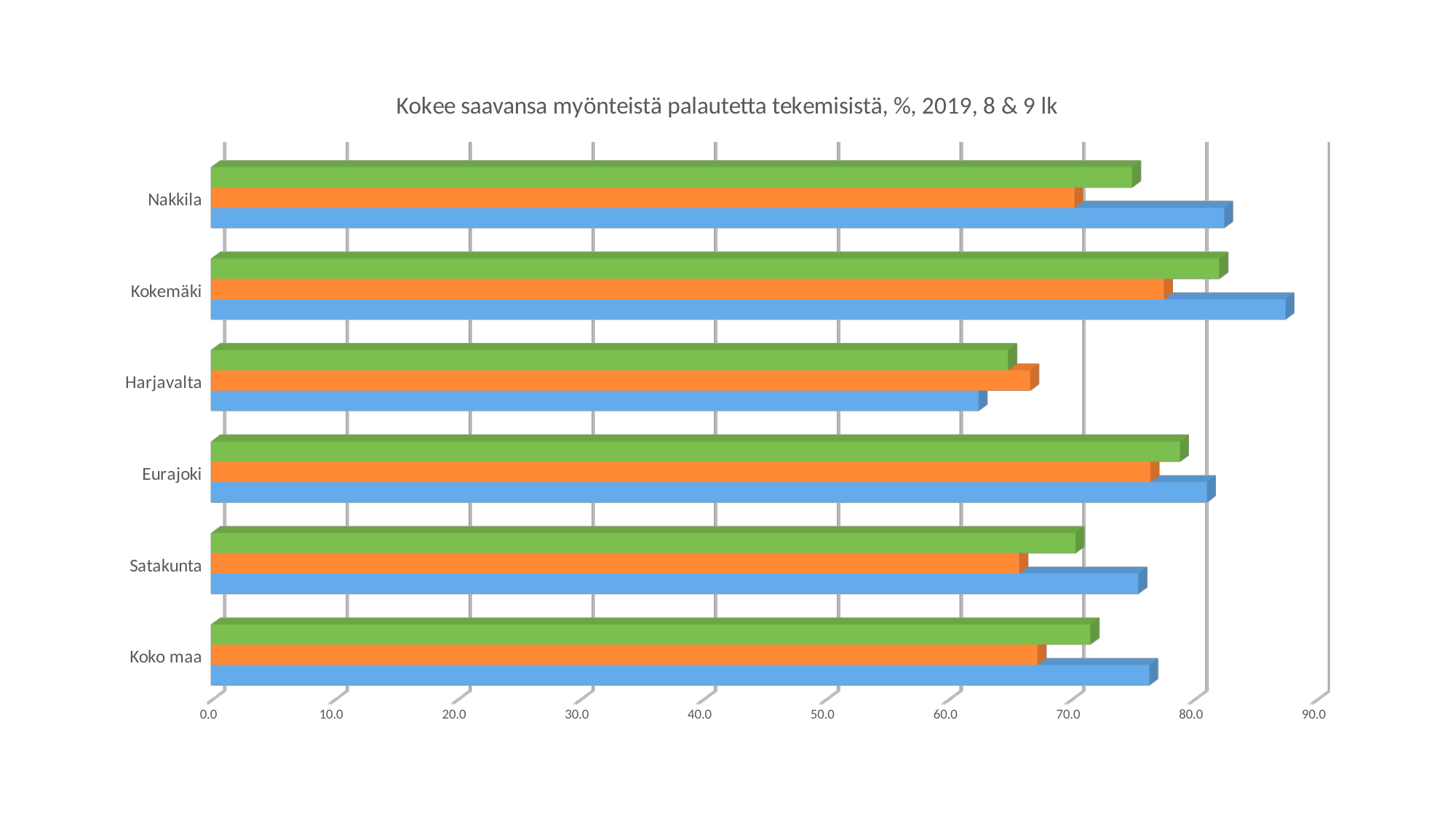
Is the value of the blue bar for Kokemäki greater or less than 80.0? greater Which category has the shortest green bar? Harjavalta Which category has the longest blue bar? Kokemäki How many bars are plotted for each category in the chart? 3 For Harjavalta, which is larger: the orange bar or the blue bar? the orange bar What is the title of the chart? Kokee saavansa myönteistä palautetta tekemisistä, %, 2019, 8 & 9 lk How many categories are shown on the vertical axis of the chart? 6 What kind of chart is shown on the slide? bar chart Is the value of the green bar for Eurajoki greater or less than 70.0? greater Is the value of the blue bar for Harjavalta greater or less than 70.0? less Which category has the shortest blue bar? Harjavalta